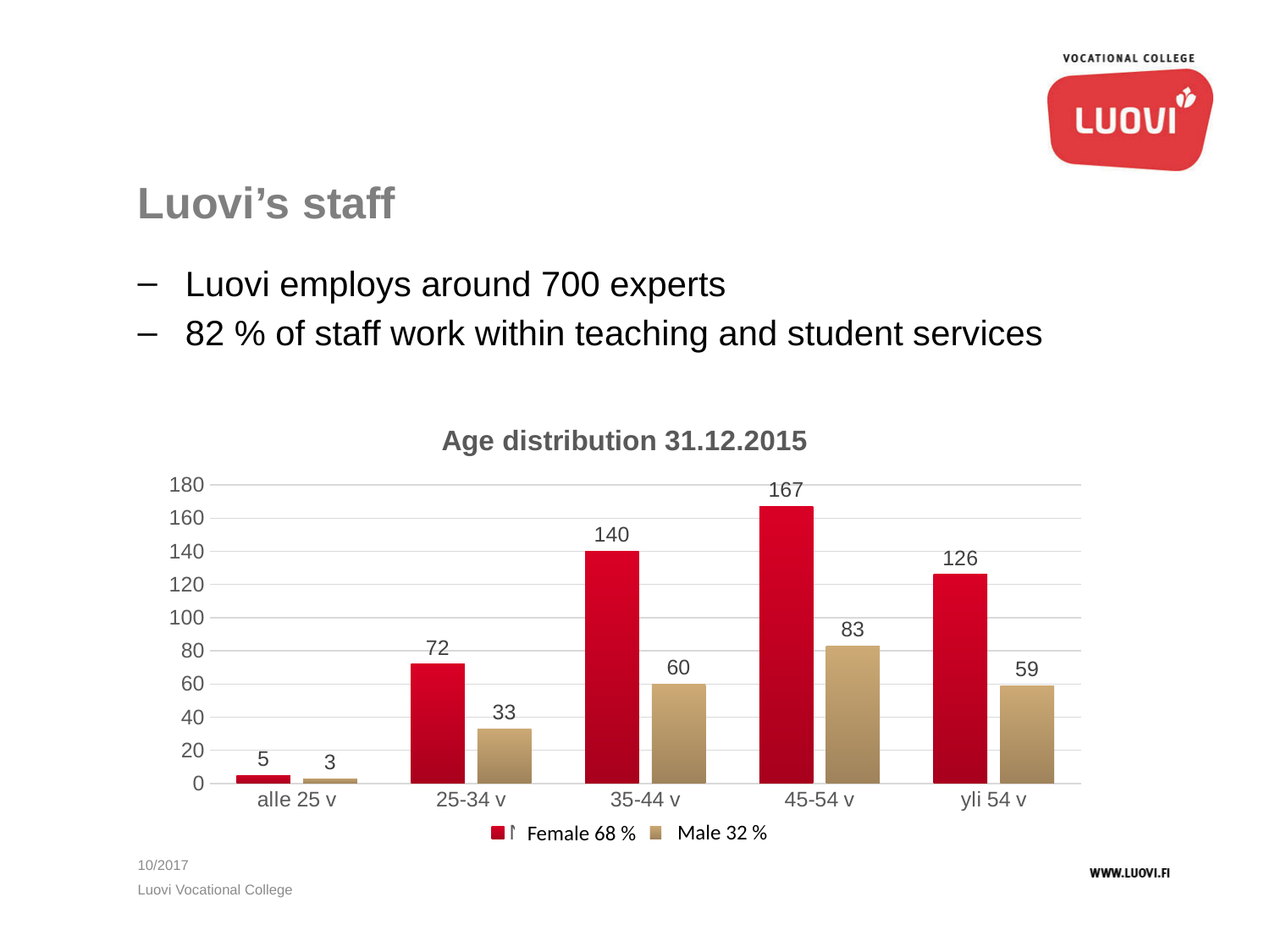
What is the title of the chart? Age distribution 31.12.2015 How many series does the legend list? 2 Which age group has the highest Female value? 45-54 v What percentage is shown next to Male in the legend? 32 % What is the total of the Female and Male values for the yli 54 v age group? 185 What is the Female value for the 45-54 v age group? 167 Which is larger, the Male value for 45-54 v or the Male value for yli 54 v? Male value for 45-54 v What kind of chart is shown on the slide? Bar chart What is the Male value for the 25-34 v age group? 33 What is the difference between the Female and Male values for the 35-44 v age group? 80 Which age group has the lowest Male value? alle 25 v How many age groups are shown on the x axis? 5